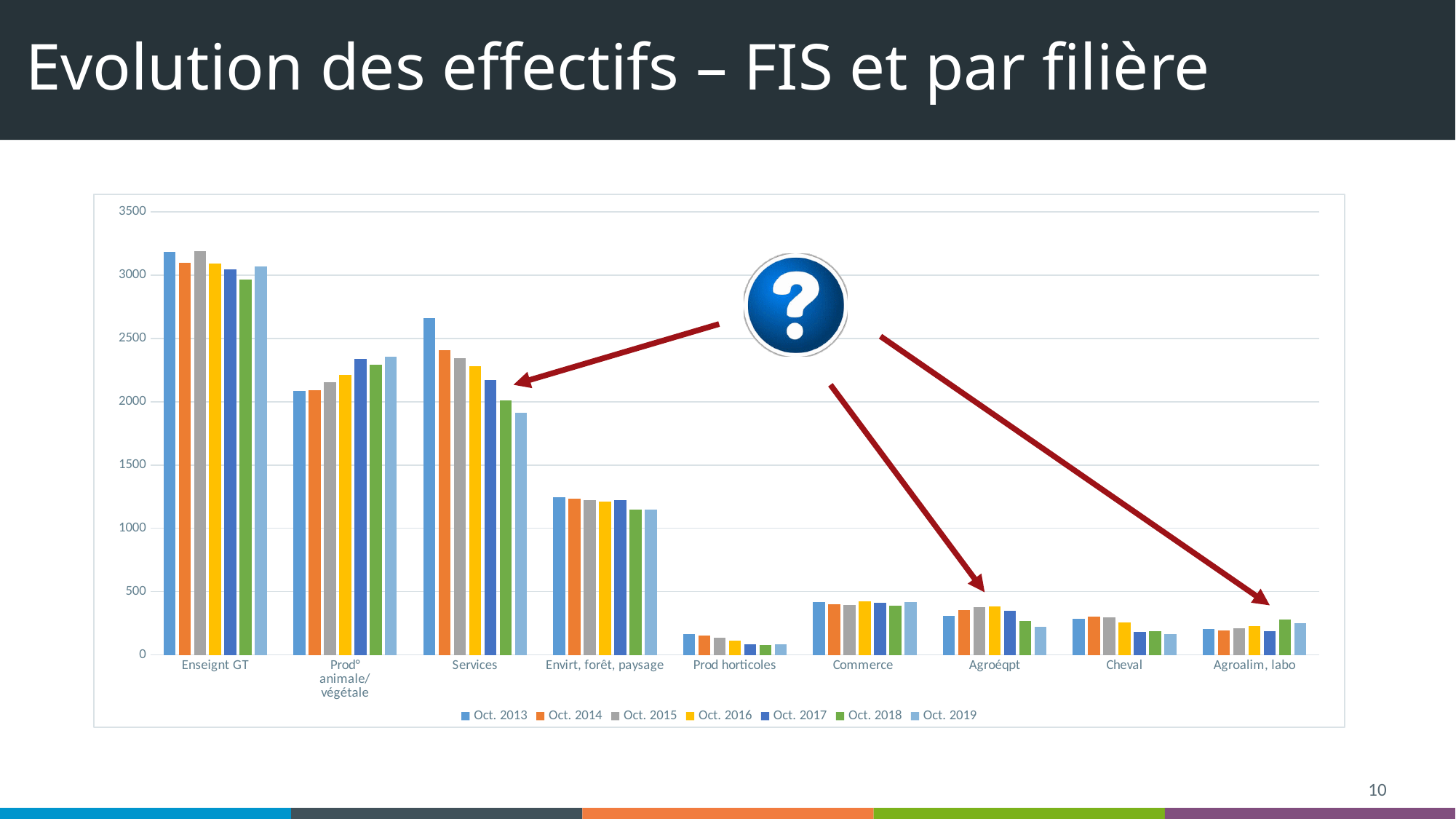
Do the values for Services rise or fall from Oct. 2013 to Oct. 2019? fall How many categories are shown on the x axis? 9 Which series is shown in orange in the legend? Oct. 2014 Is the value for Commerce in Oct. 2013 greater or less than 500? less How many series does the legend list? 7 Which category has the highest values overall? Enseignt GT What kind of chart is shown on the slide? bar chart Which is larger in Oct. 2013: Services or Prod° animale/végétale? Services Which category has the lowest values overall? Prod horticoles Is the value for Enseignt GT in Oct. 2013 greater or less than 3000? greater Do the values for Prod° animale/végétale rise or fall from Oct. 2013 to Oct. 2019? rise Is the value for Services in Oct. 2019 greater or less than 2000? less